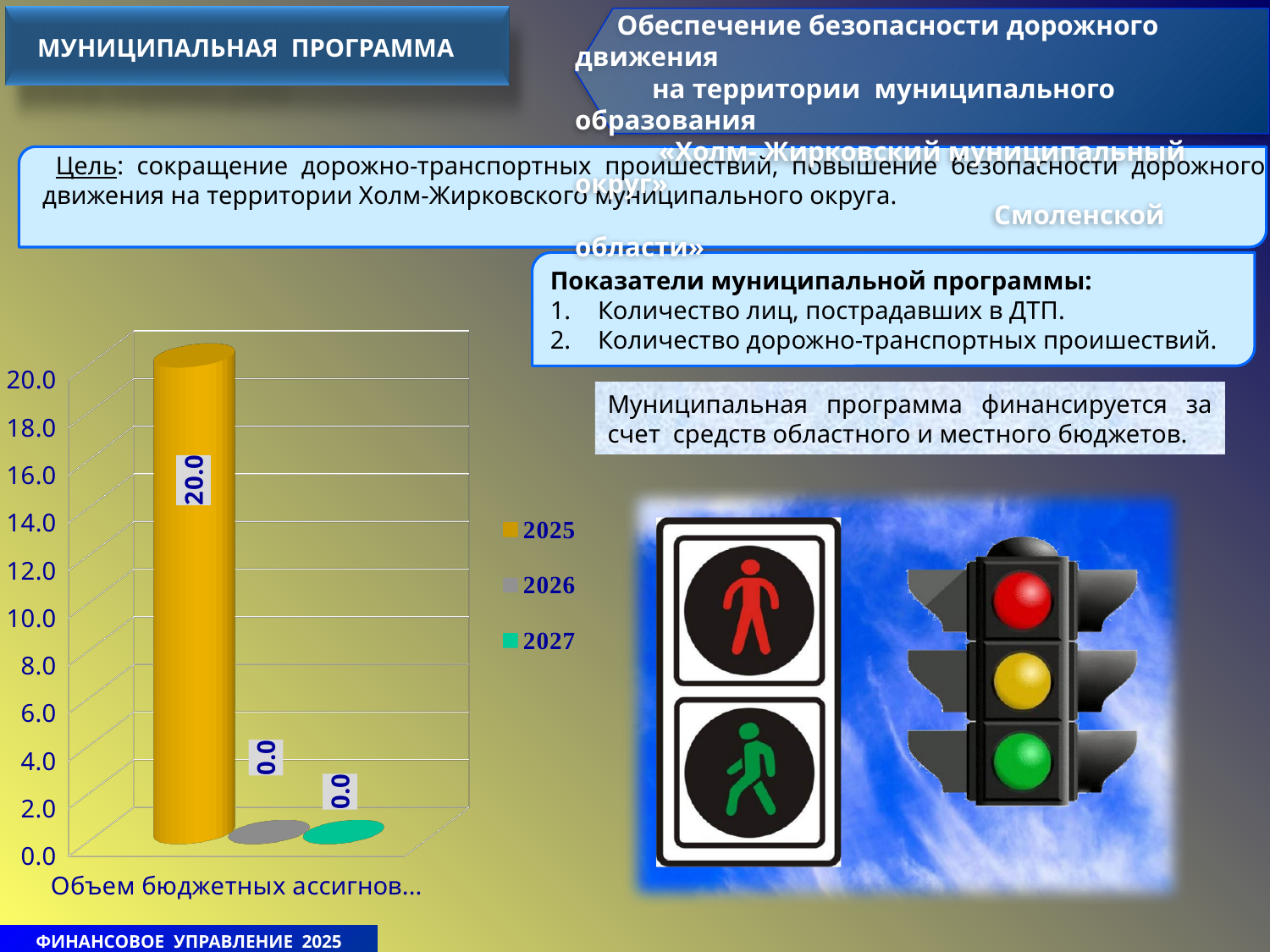
What is the total of the values for 2025, 2026 and 2027? 20.0 Which series has the highest value in the chart? 2025 What is the difference between the values for 2025 and 2026? 20.0 What is the value for 2026 in the chart? 0.0 What is the value for 2027 in the chart? 0.0 What kind of chart is shown on the slide? bar chart What is the highest value shown on the vertical axis of the chart? 20.0 Which is larger, the value for 2025 or the value for 2027? 2025 Is the value for 2025 greater or less than 10.0? greater How many series does the legend list? 3 What colour is the bar for 2025 in the chart? yellow What is the value for 2025 in the chart? 20.0